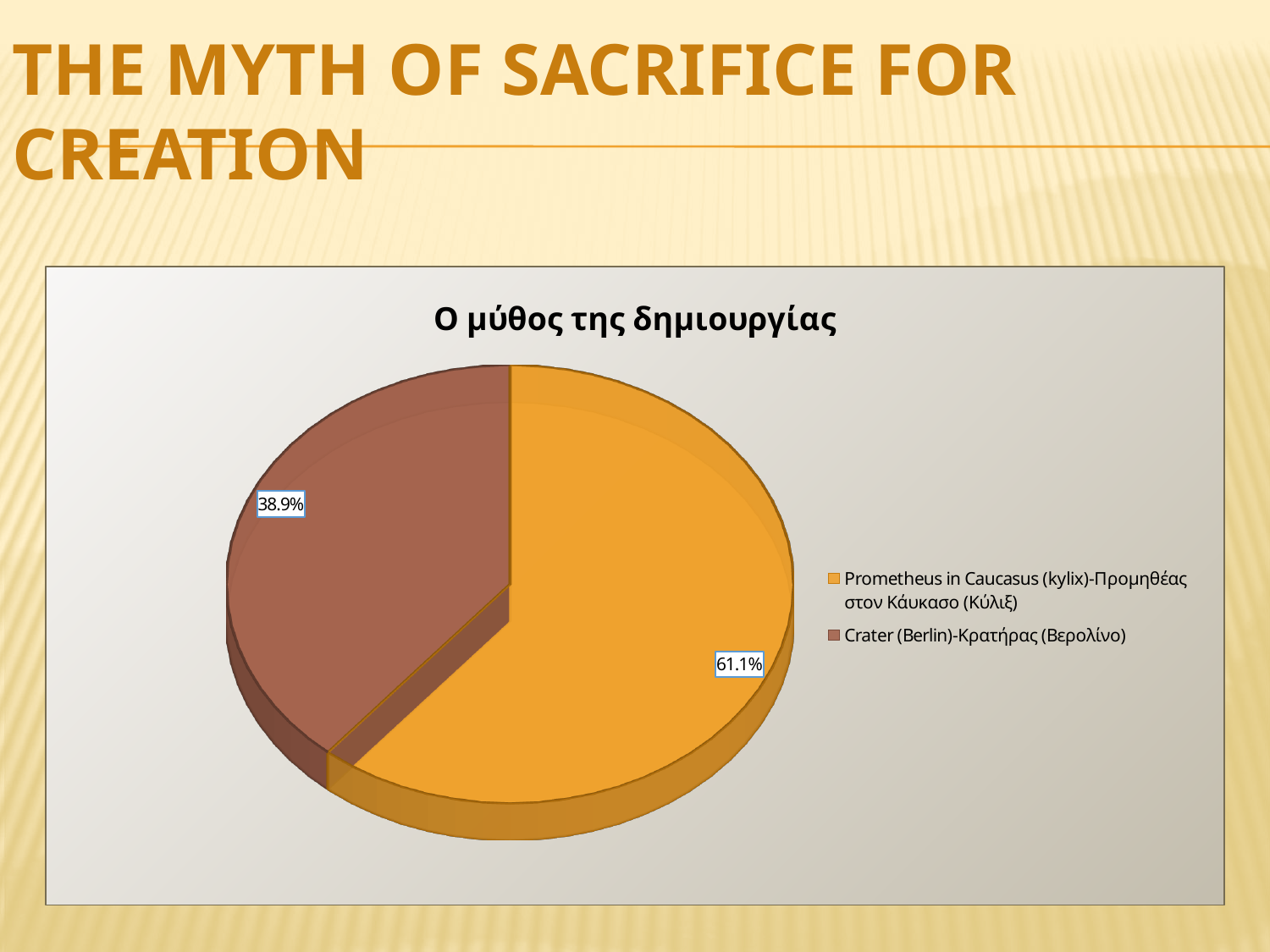
What kind of chart is shown on the slide? pie chart How many slices does the pie chart have? 2 What share of the pie does the Crater (Berlin) slice represent? 38.9% Which slice is the smallest? Crater (Berlin)-Κρατήρας (Βερολίνο) What is the chart's title? Ο μύθος της δημιουργίας What is the difference in percentage points between the Prometheus in Caucasus slice and the Crater (Berlin) slice? 22.2 What colour is the Crater (Berlin) slice? brown Which slice is the largest? Prometheus in Caucasus (kylix)-Προμηθέας στον Κάυκασο (Κύλιξ) How many entries does the legend list? 2 What share of the pie does the Prometheus in Caucasus (kylix) slice represent? 61.1% Which is larger, the Crater (Berlin) slice or the Prometheus in Caucasus slice? Prometheus in Caucasus